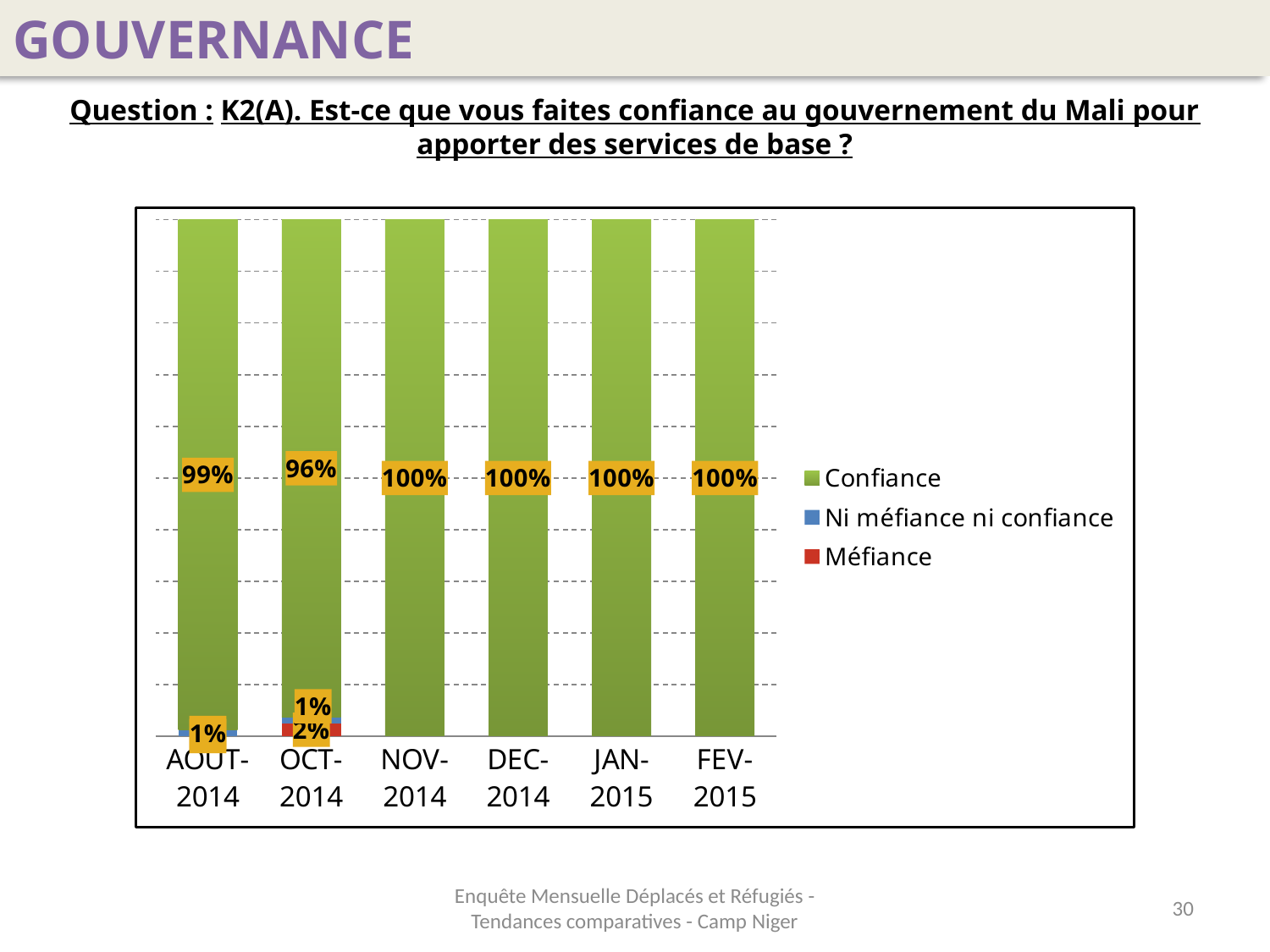
What is the last legend entry? Méfiance What is the Confiance value for JAN-2015? 100% Which series is shown in green? Confiance How many months are shown on the x axis? 6 Which is larger, the Confiance value for AOUT-2014 or for OCT-2014? AOUT-2014 Which month has the lowest Confiance value? OCT-2014 How many months show a Confiance value of 100%? 4 What kind of chart is shown on the slide? Stacked bar chart How many series does the legend list? 3 What is the difference between the Confiance values for AOUT-2014 and OCT-2014? 3% What is the Confiance value for OCT-2014? 96% What is the Confiance value for AOUT-2014? 99%